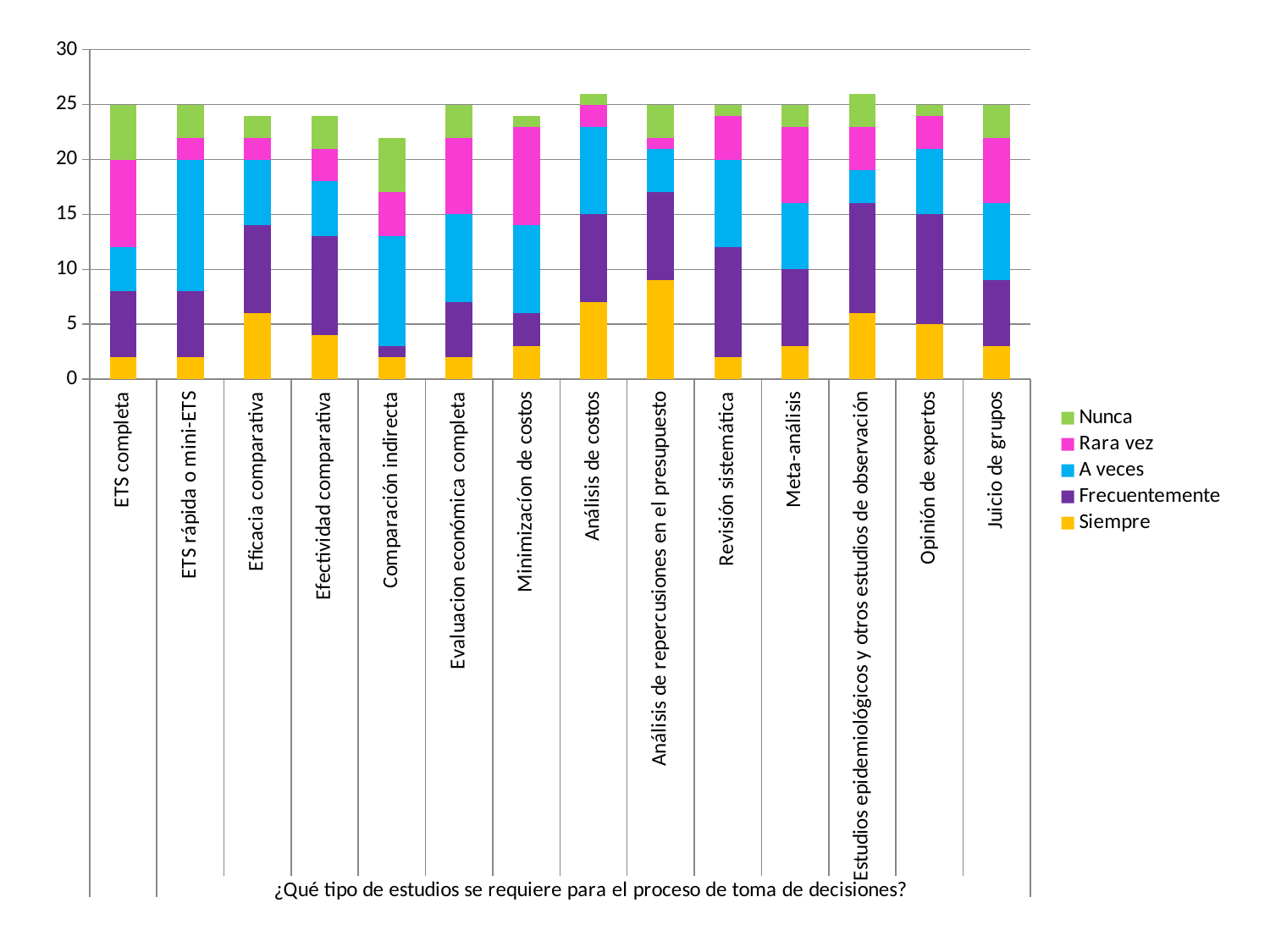
What is the total bar height for ETS completa? 25 Which category has the lowest total bar height? Comparación indirecta Is the total bar height for Comparación indirecta greater or less than 25? less What kind of chart is shown on the slide? stacked bar chart Which has a larger Siempre segment, Eficacia comparativa or ETS completa? Eficacia comparativa How many series does the legend list? 5 What is the Siempre value for Opinión de expertos? 5 Which category has the largest Siempre segment? Análisis de repercusiones en el presupuesto How many study types (categories) are shown on the x axis? 14 Which series is shown in green in the legend? Nunca What is the x-axis title of the chart? ¿Qué tipo de estudios se requiere para el proceso de toma de decisiones? Is the Siempre value for Análisis de repercusiones en el presupuesto greater or less than 5? greater